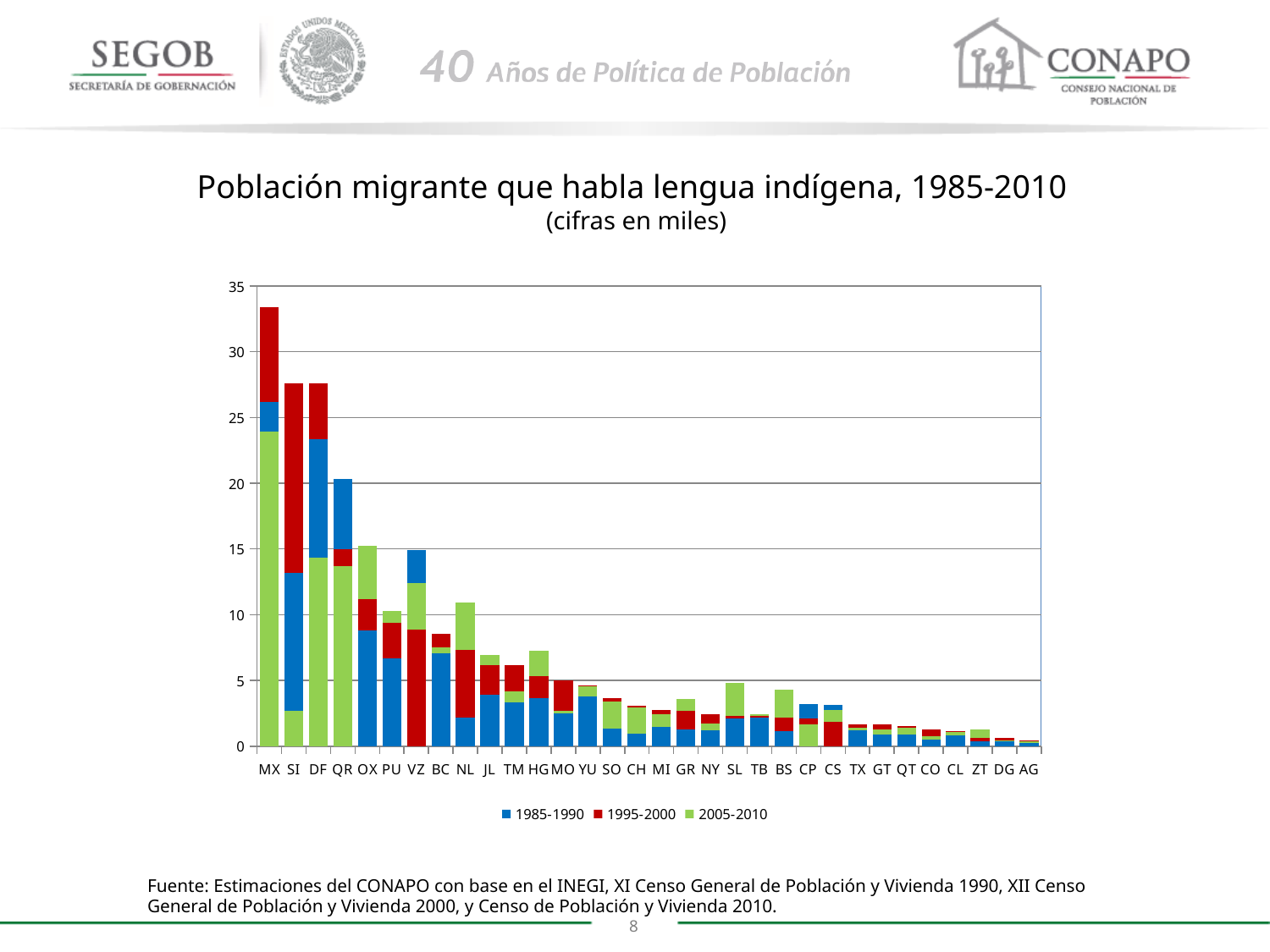
How many categories (states) are shown on the x axis? 32 Is the total value for SI greater or less than 25? greater Which category has the highest total stacked bar? MX Which period does the green series in the legend represent? 2005-2010 What kind of chart is shown on the slide? Stacked bar chart Which category has the lowest total stacked bar? AG Is the total value for BC greater or less than 10? less Do the total bar heights generally rise or fall from left to right along the x axis? fall Is the total value for MX greater or less than 30? greater Which has the larger total stacked bar, DF or QR? DF How many series does the legend list? 3